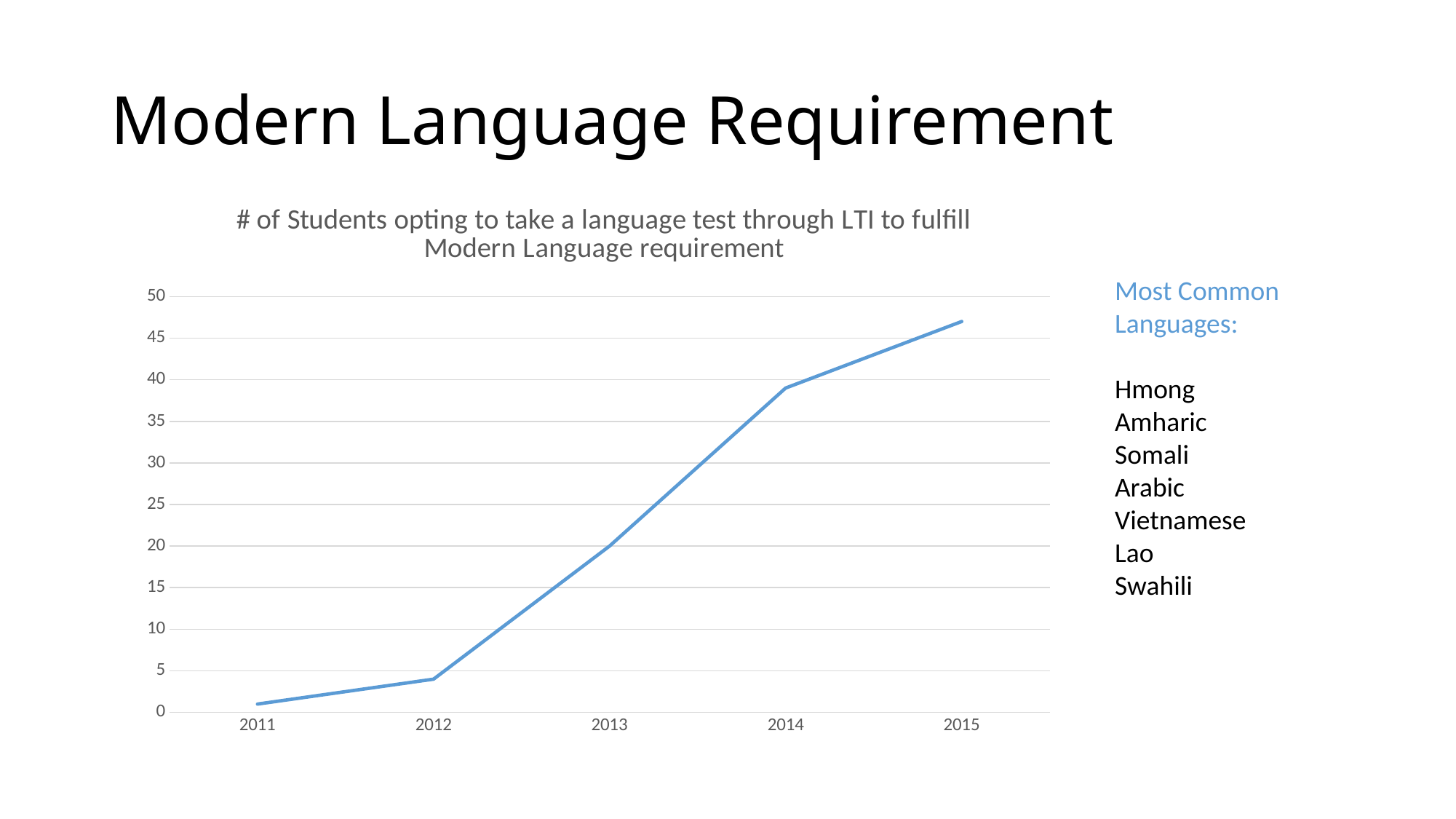
Which year has a larger value, 2013 or 2014? 2014 Is the value for 2014 greater or less than 35? greater What is the highest value shown on the y axis of the chart? 50 Which year has the lowest number of students opting to take a language test through LTI? 2011 Do the values rise or fall from 2011 to 2015? rise Which year has the highest number of students opting to take a language test through LTI? 2015 What kind of chart is shown on the slide? line chart What is the title of the chart? # of Students opting to take a language test through LTI to fulfill Modern Language requirement Is the value for 2012 greater or less than 5? less Is the value for 2015 greater or less than 45? greater How many years are plotted on the x axis of the chart? 5